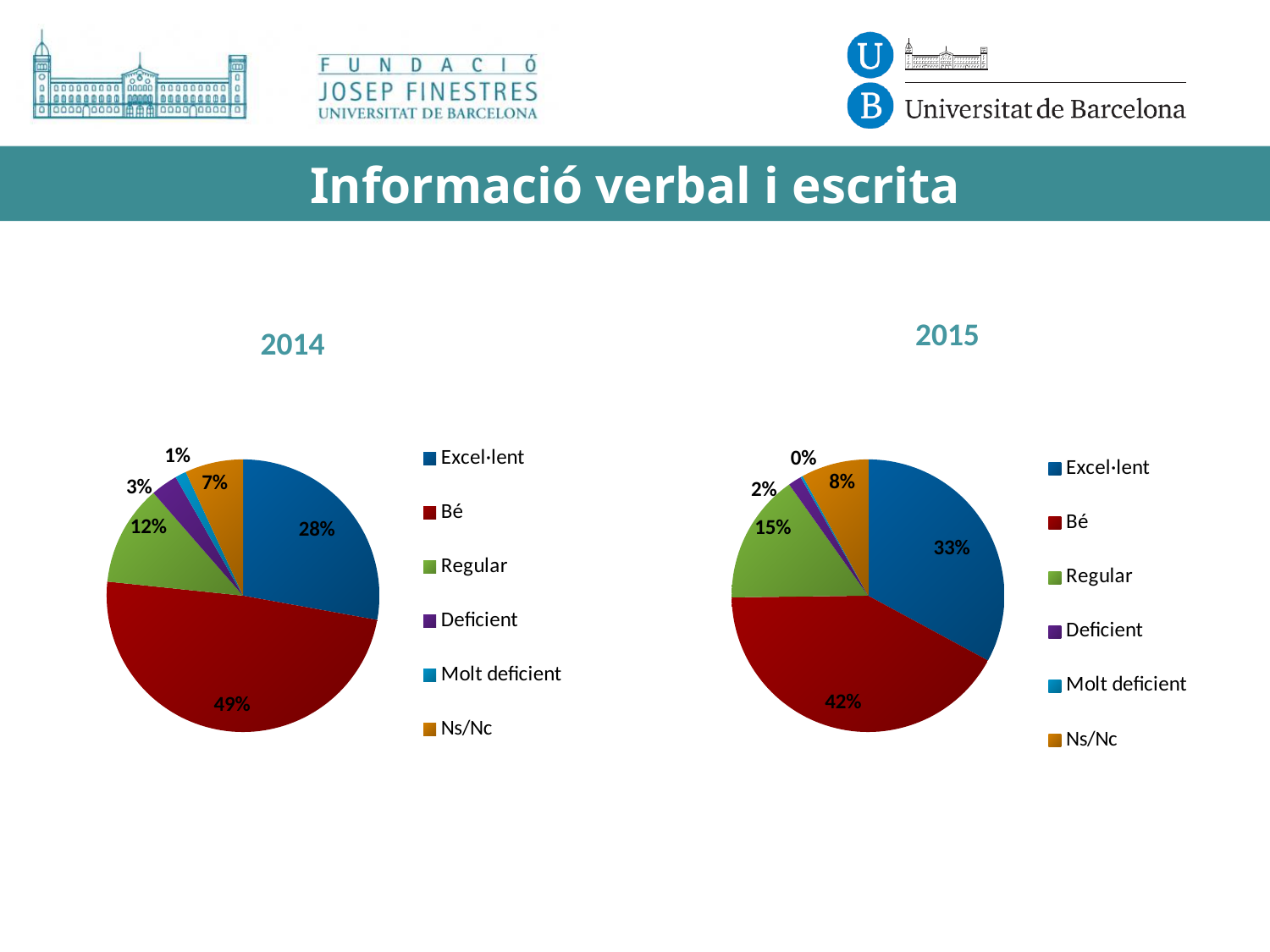
In the 2014 chart, what percentage is shown for Bé? 49% In the 2015 chart, what is the difference between the Regular and Deficient percentages? 13% In the 2014 chart, which category has the smallest slice? Molt deficient Which is larger: Excel·lent in the 2014 chart or Excel·lent in the 2015 chart? 2015 In the 2015 chart, which category has the largest slice? Bé How many categories does the legend of the 2014 chart list? 6 What kind of chart is used for the 2015 data? Pie chart In the 2014 chart, what percentage is shown for Regular? 12% In the 2015 chart, what percentage is shown for Excel·lent? 33% In the 2014 chart, what is the difference between the Bé and Excel·lent percentages? 21% In the 2015 chart, what percentage is shown for Ns/Nc? 8% What is the title of the slide containing the two charts? Informació verbal i escrita